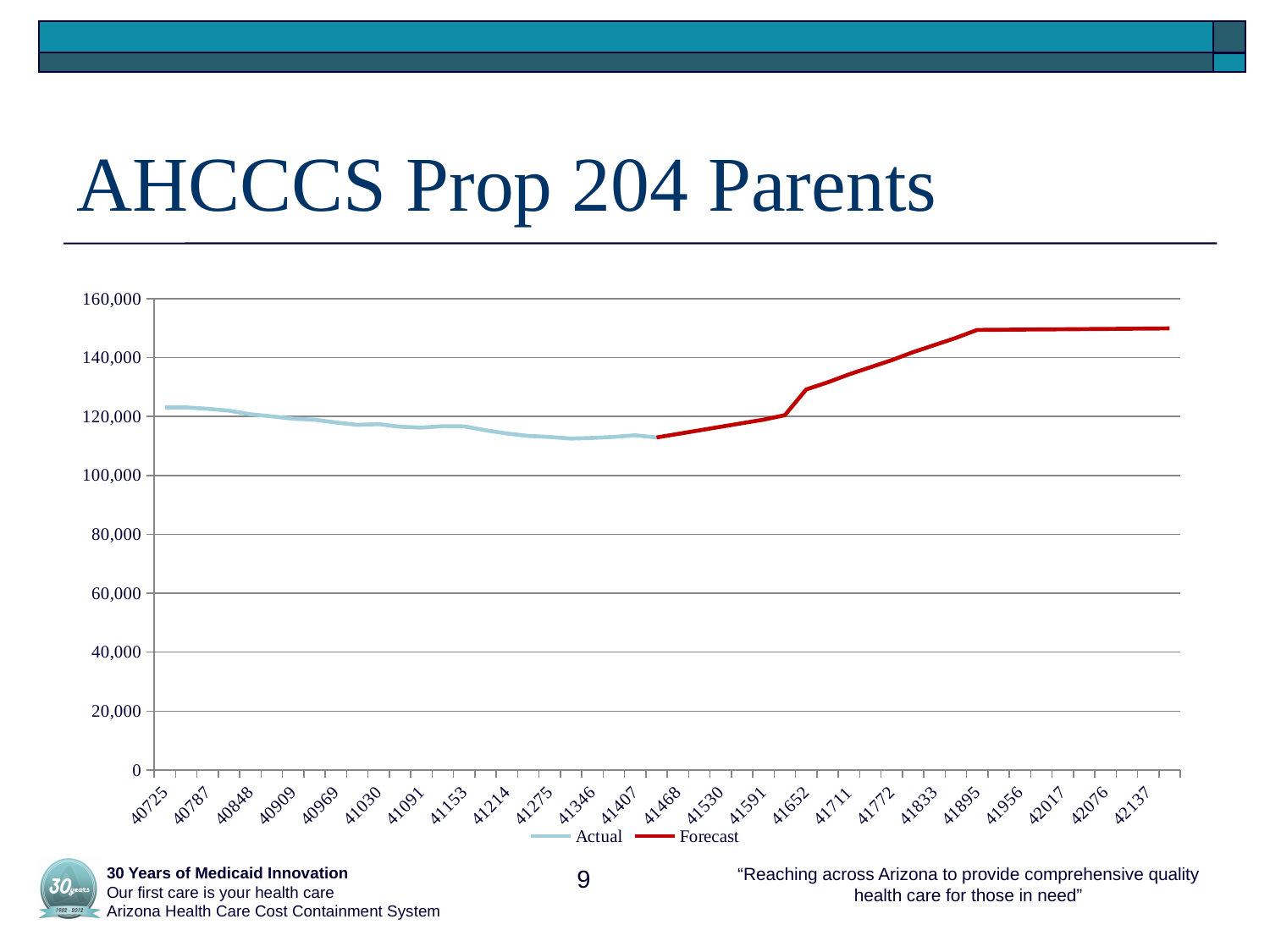
How many series does the legend list? 2 Is the Forecast value at 42137 greater or less than 140,000? greater Which is larger: the Forecast value at 42137 or the Actual value at 40725? Forecast value at 42137 Is the Forecast value at 41652 greater or less than 140,000? less Does the Actual series generally rise or fall from 40725 to 41468? Fall What colour is the Forecast line? Red Is the Actual value at 41346 greater or less than 120,000? less Does the Forecast series generally rise or fall from 41468 to 42137? Rise How many labels are shown along the x axis? 24 What kind of chart is shown on the slide? Line chart What are the two series named in the legend? Actual and Forecast